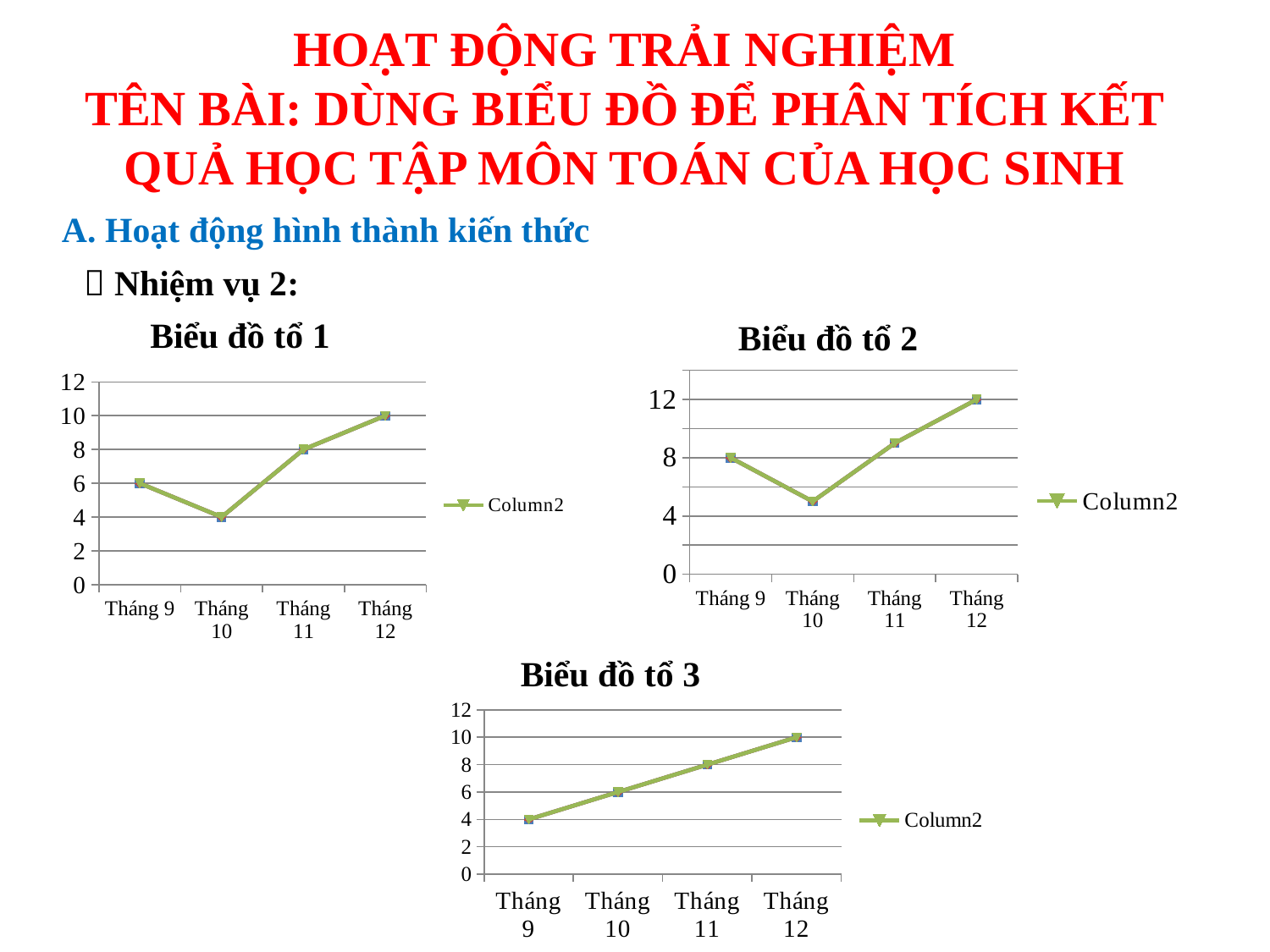
How many months are shown on the x axis of the chart titled 'Biểu đồ tổ 3'? 4 In the chart titled 'Biểu đồ tổ 2', is the value for Tháng 10 greater or less than 8? less In the chart titled 'Biểu đồ tổ 3', do the values rise or fall from Tháng 9 to Tháng 12? rise In the chart titled 'Biểu đồ tổ 1', what is the value for Tháng 10? 4 What kind of chart is 'Biểu đồ tổ 1'? line chart In the chart titled 'Biểu đồ tổ 1', what is the value for Tháng 12? 10 In the chart titled 'Biểu đồ tổ 3', what is the value for Tháng 9? 4 In the chart titled 'Biểu đồ tổ 2', what is the value for Tháng 12? 12 In the chart titled 'Biểu đồ tổ 1', which month has the lowest value? Tháng 10 In the chart titled 'Biểu đồ tổ 3', what is the difference between the values for Tháng 11 and Tháng 10? 2 In the chart titled 'Biểu đồ tổ 1', what is the difference between the values for Tháng 12 and Tháng 9? 4 In the chart titled 'Biểu đồ tổ 2', which month has the highest value? Tháng 12